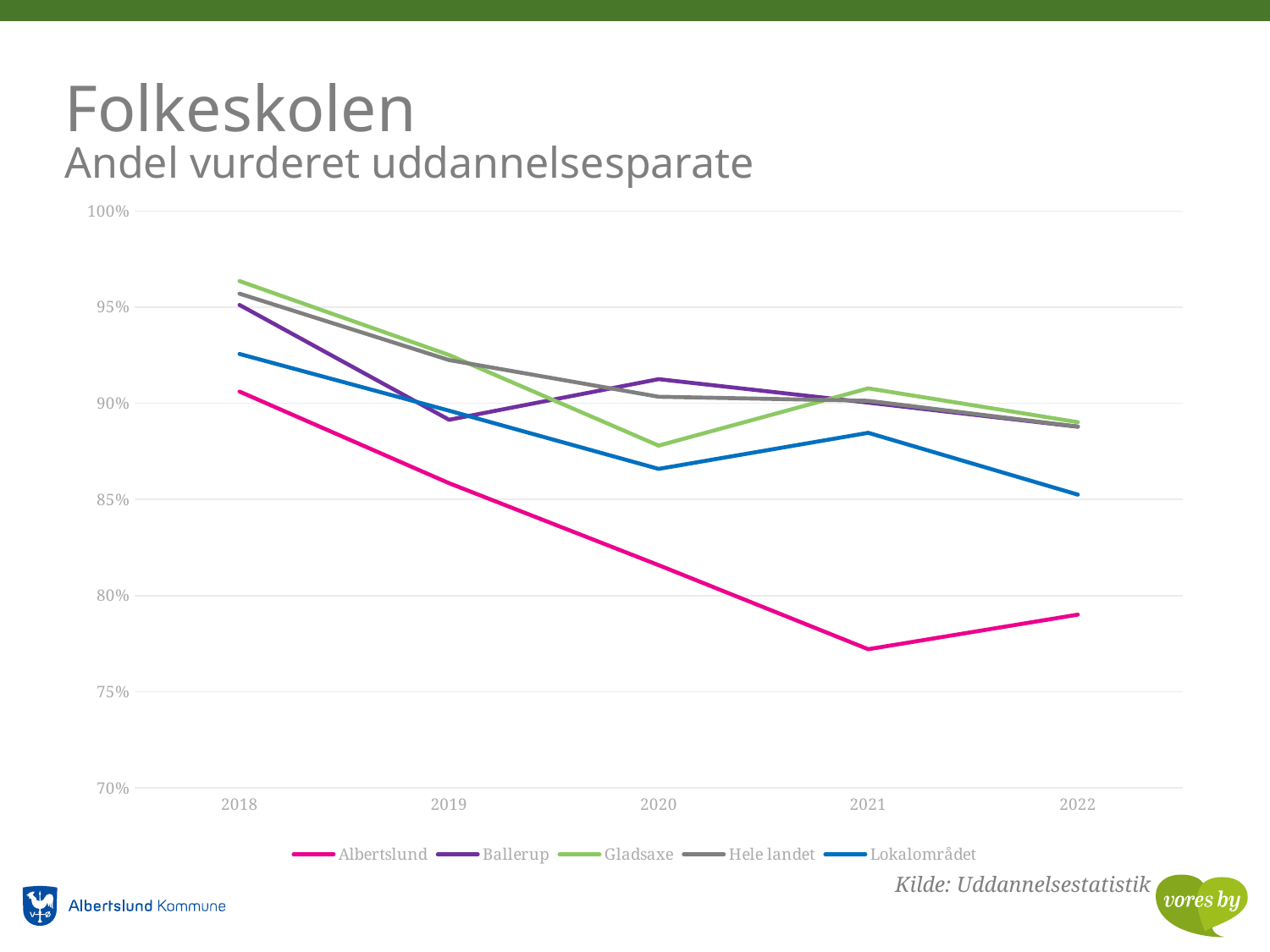
How many series does the legend list? 5 What kind of chart is shown on the slide? Line chart In which year does Albertslund reach its lowest value? 2021 Is the value for Gladsaxe in 2018 greater or less than 95%? greater Which series has the lowest value in 2021? Albertslund Is the value for Albertslund in 2021 greater or less than 80%? less Is the value for Albertslund in 2018 greater or less than 85%? greater In 2020, which is larger: Albertslund or Lokalområdet? Lokalområdet Which series has the highest value in 2018? Gladsaxe What source is cited for the chart? Uddannelsesstatistik How many years are shown on the x axis? 5 Does the Albertslund line rise or fall from 2018 to 2021? Fall